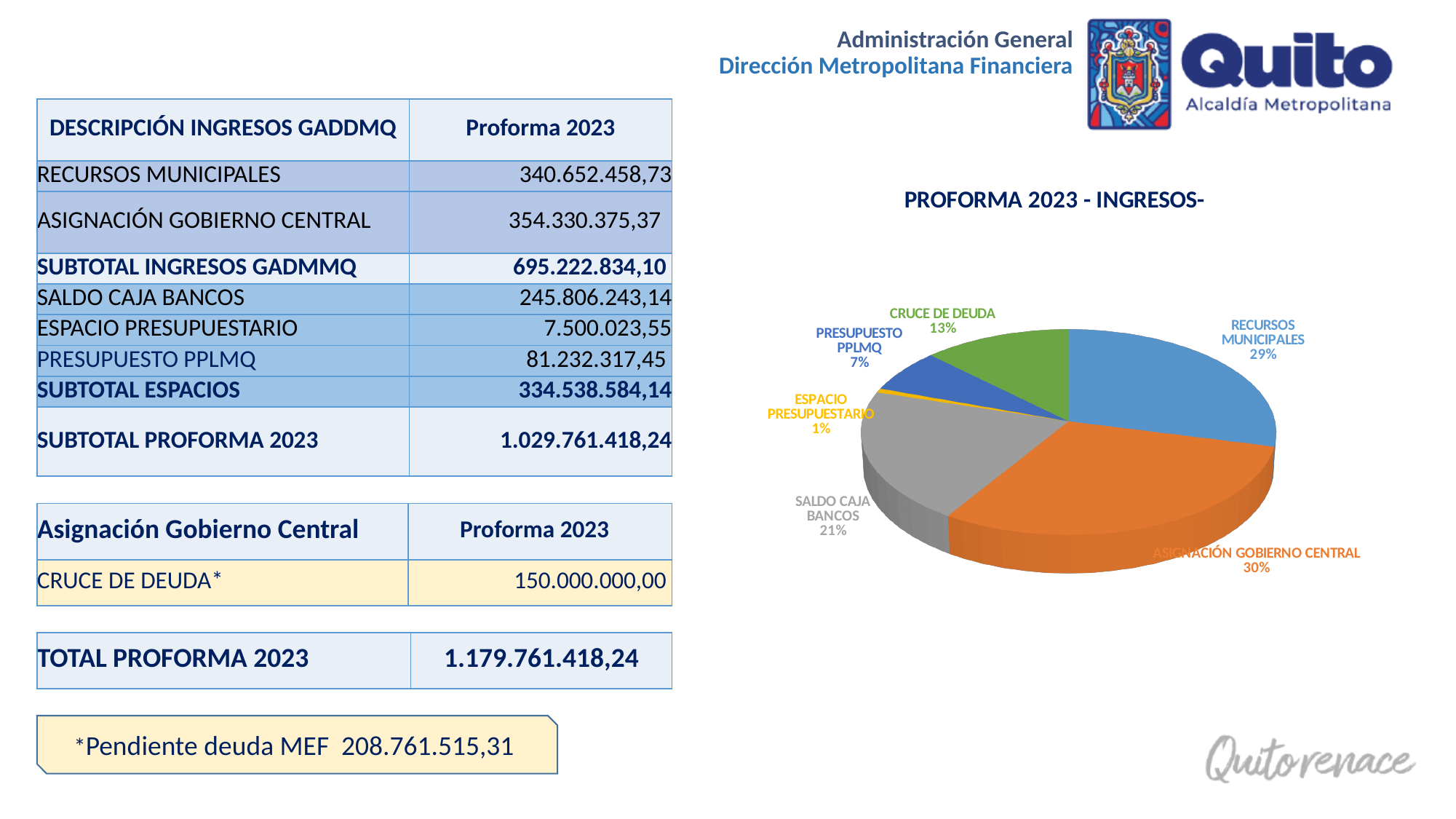
Which slice of the pie chart is the smallest? ESPACIO PRESUPUESTARIO What is the difference in percentage points between ASIGNACIÓN GOBIERNO CENTRAL and SALDO CAJA BANCOS? 9% What share of the pie does RECURSOS MUNICIPALES represent? 29% What share of the pie does SALDO CAJA BANCOS represent? 21% What share of the pie does ASIGNACIÓN GOBIERNO CENTRAL represent? 30% What type of chart is shown on the slide? Pie chart Which slice of the pie chart is the largest? ASIGNACIÓN GOBIERNO CENTRAL Which has a larger share, CRUCE DE DEUDA or PRESUPUESTO PPLMQ? CRUCE DE DEUDA How many slices does the pie chart have? 6 What is the title of the chart? PROFORMA 2023 - INGRESOS-